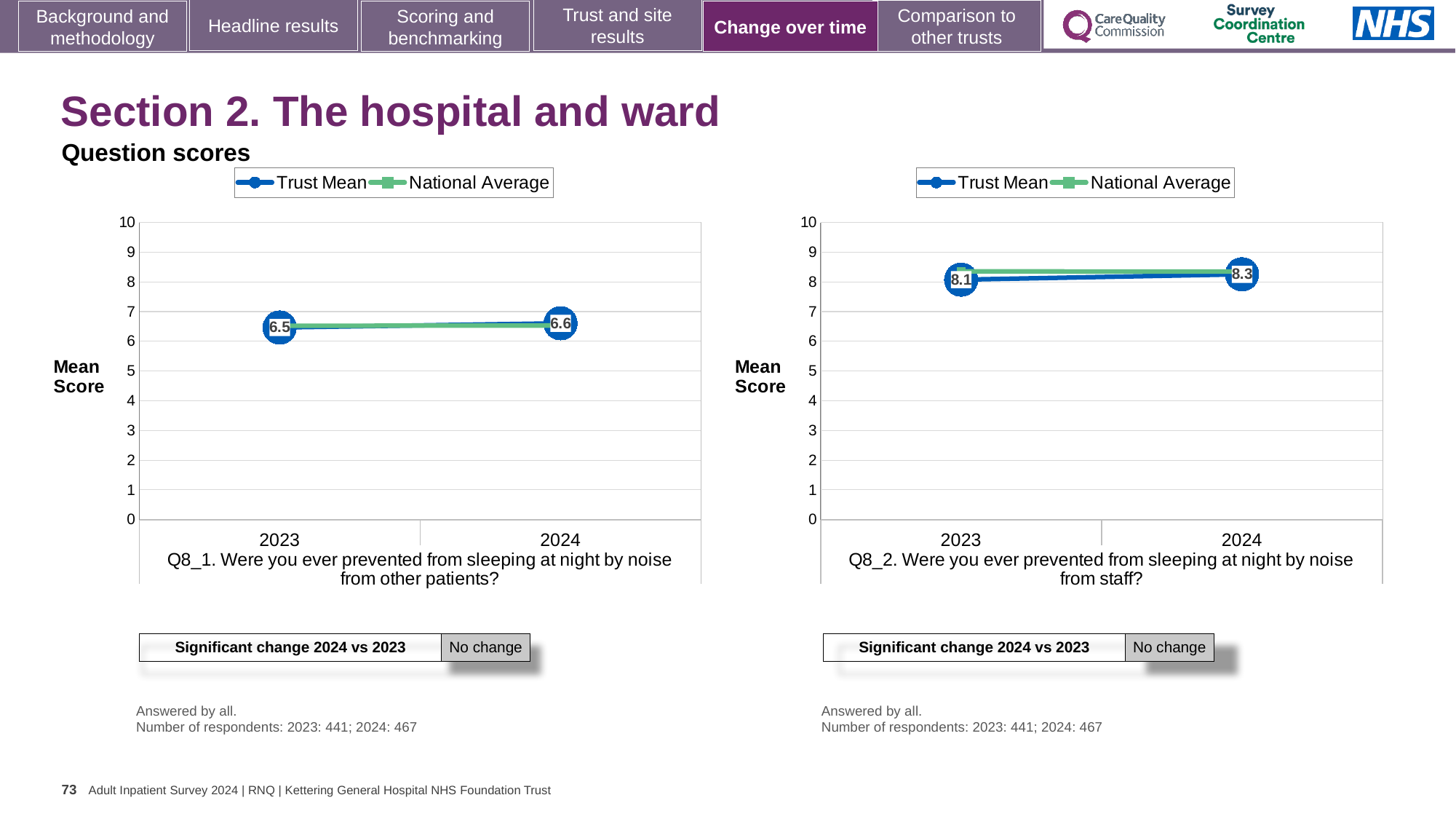
In the Q8_2 chart (right), what is the Trust Mean score for 2024? 8.3 In the Q8_1 chart (left), what is the Trust Mean score for 2024? 6.6 In the Q8_1 chart (left), is the Trust Mean for 2024 greater or less than 7? less In the Q8_1 chart (left), what is the Trust Mean score for 2023? 6.5 In the Q8_2 chart (right), by how much did the Trust Mean change from 2023 to 2024? 0.2 How many years are plotted on the x axis of the Q8_1 chart (left)? 2 What is the label on the y axis of the Q8_2 chart (right)? Mean Score What type of chart is the Q8_1 chart on the left? Line chart In the Q8_1 chart (left), by how much did the Trust Mean change from 2023 to 2024? 0.1 How many series does the legend of the Q8_2 chart (right) list? 2 In the Q8_2 chart (right), does the Trust Mean rise or fall from 2023 to 2024? Rise In the Q8_2 chart (right), what is the Trust Mean score for 2023? 8.1